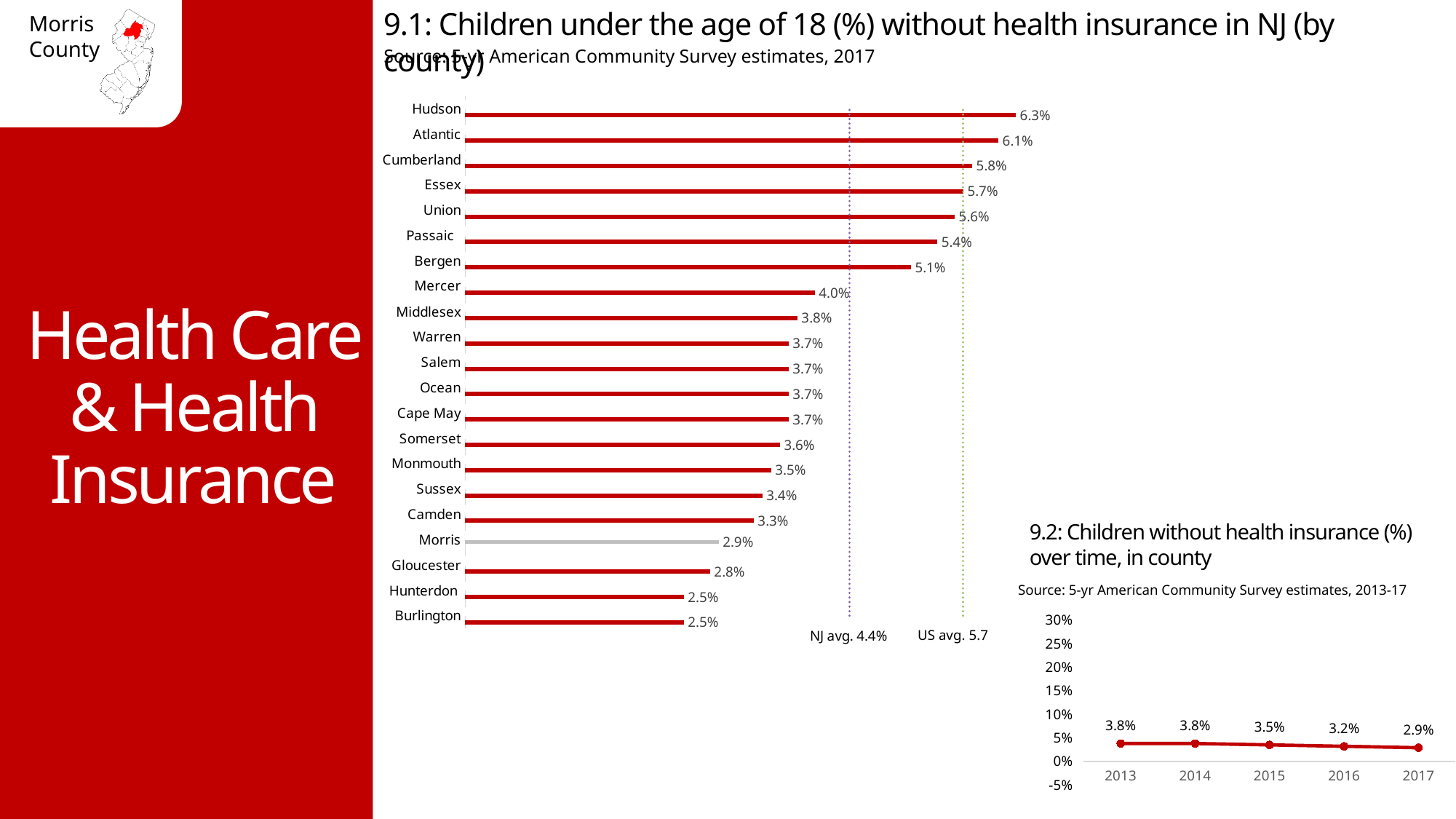
In chart 9.2 (children without health insurance over time, in county), what is the difference between the 2013 and 2017 values? 0.9% What kind of chart is chart 9.1 (children under 18 without health insurance by county)? Bar chart In chart 9.2 (children without health insurance over time, in county), do the values rise or fall from 2013 to 2017? Fall In chart 9.1 (children under 18 without health insurance by county), what is the value for Morris? 2.9% In chart 9.1 (children under 18 without health insurance by county), what is the NJ average shown by the dotted line? 4.4% In chart 9.1 (children under 18 without health insurance by county), which county has the highest value? Hudson In chart 9.2 (children without health insurance over time, in county), what is the value for 2015? 3.5% In chart 9.1 (children under 18 without health insurance by county), what is the value for Hudson? 6.3% In chart 9.1 (children under 18 without health insurance by county), what is the difference between Hudson and Morris? 3.4% In chart 9.1 (children under 18 without health insurance by county), how many counties are plotted? 21 In chart 9.1 (children under 18 without health insurance by county), which is larger, the value for Bergen or the value for Mercer? Bergen In chart 9.2 (children without health insurance over time, in county), how many years are plotted? 5